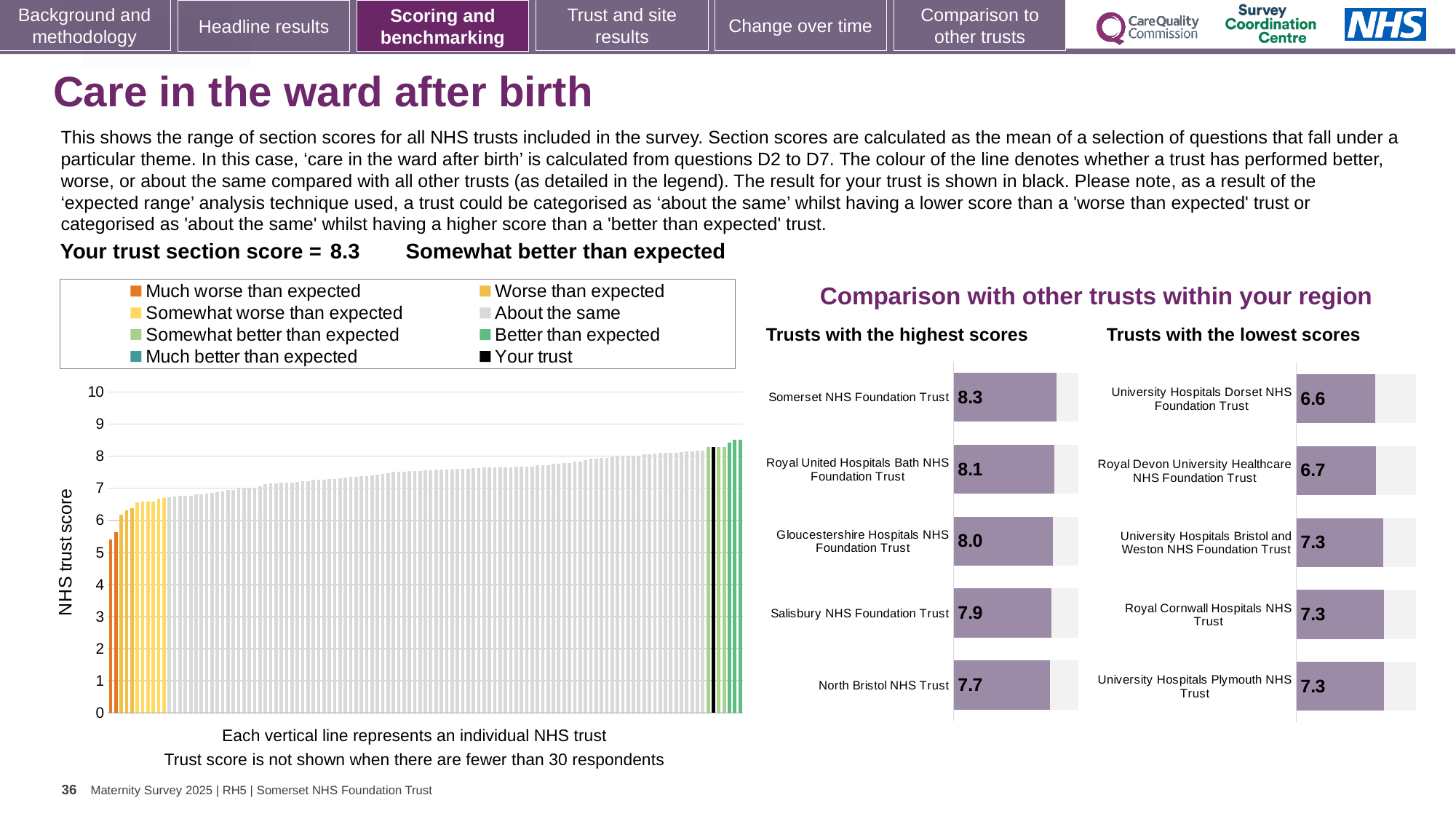
In the 'Trusts with the highest scores' chart, what is the score for Gloucestershire Hospitals NHS Foundation Trust? 8.0 Comparing the two regional charts, which has the higher score: Salisbury NHS Foundation Trust or Royal Cornwall Hospitals NHS Trust? Salisbury NHS Foundation Trust In the 'Trusts with the highest scores' chart, which trust has the highest score? Somerset NHS Foundation Trust How many trusts are listed in the 'Trusts with the highest scores' chart? 5 In the 'Trusts with the highest scores' chart, what is the difference between the scores of Somerset NHS Foundation Trust and North Bristol NHS Trust? 0.6 In the 'Trusts with the lowest scores' chart, what is the score for Royal Devon University Healthcare NHS Foundation Trust? 6.7 In the main 'NHS trust score' chart, do the bar heights rise or fall from left to right? Rise In the main 'NHS trust score' chart, is the value of the black 'Your trust' bar greater or less than 8? greater How many entries does the legend of the main 'NHS trust score' chart list? 8 What is the y-axis title of the main bar chart on the left? NHS trust score What kind of chart is the main chart with the 'NHS trust score' axis? Bar chart In the 'Trusts with the lowest scores' chart, which trust has the lowest score? University Hospitals Dorset NHS Foundation Trust